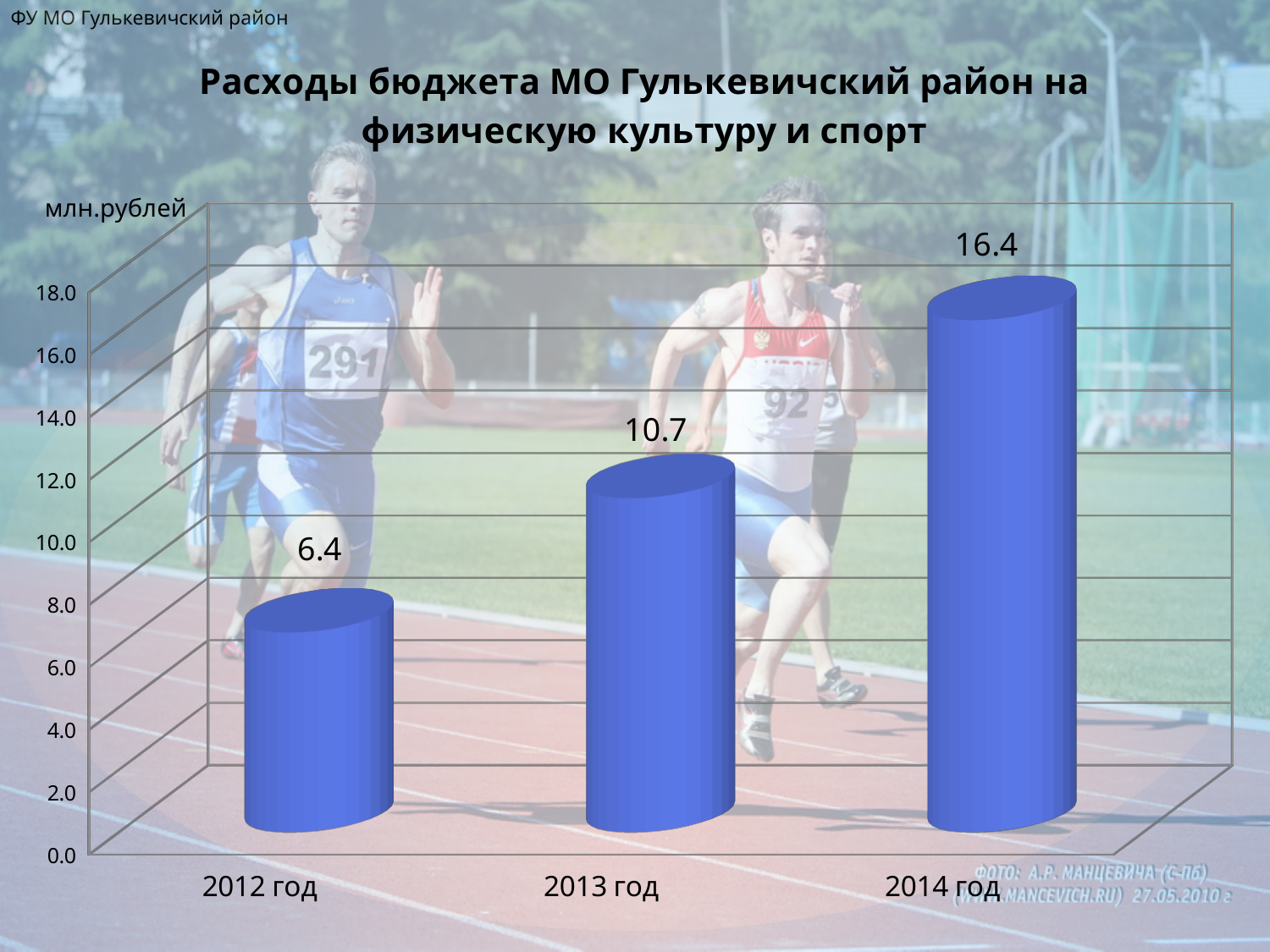
What is the value for 2014 год? 16.4 What is the difference between the values for 2013 год and 2012 год? 4.3 What is the value for 2013 год? 10.7 What unit is shown on the vertical axis of the chart? млн.рублей What is the value for 2012 год? 6.4 How many categories are shown on the chart? 3 Which is larger, the value for 2013 год or the value for 2014 год? 2014 год What is the difference between the values for 2014 год and 2012 год? 10.0 What kind of chart is this? bar chart Which year has the lowest value? 2012 год Which year has the highest value? 2014 год Do the values rise or fall from 2012 год to 2014 год? rise